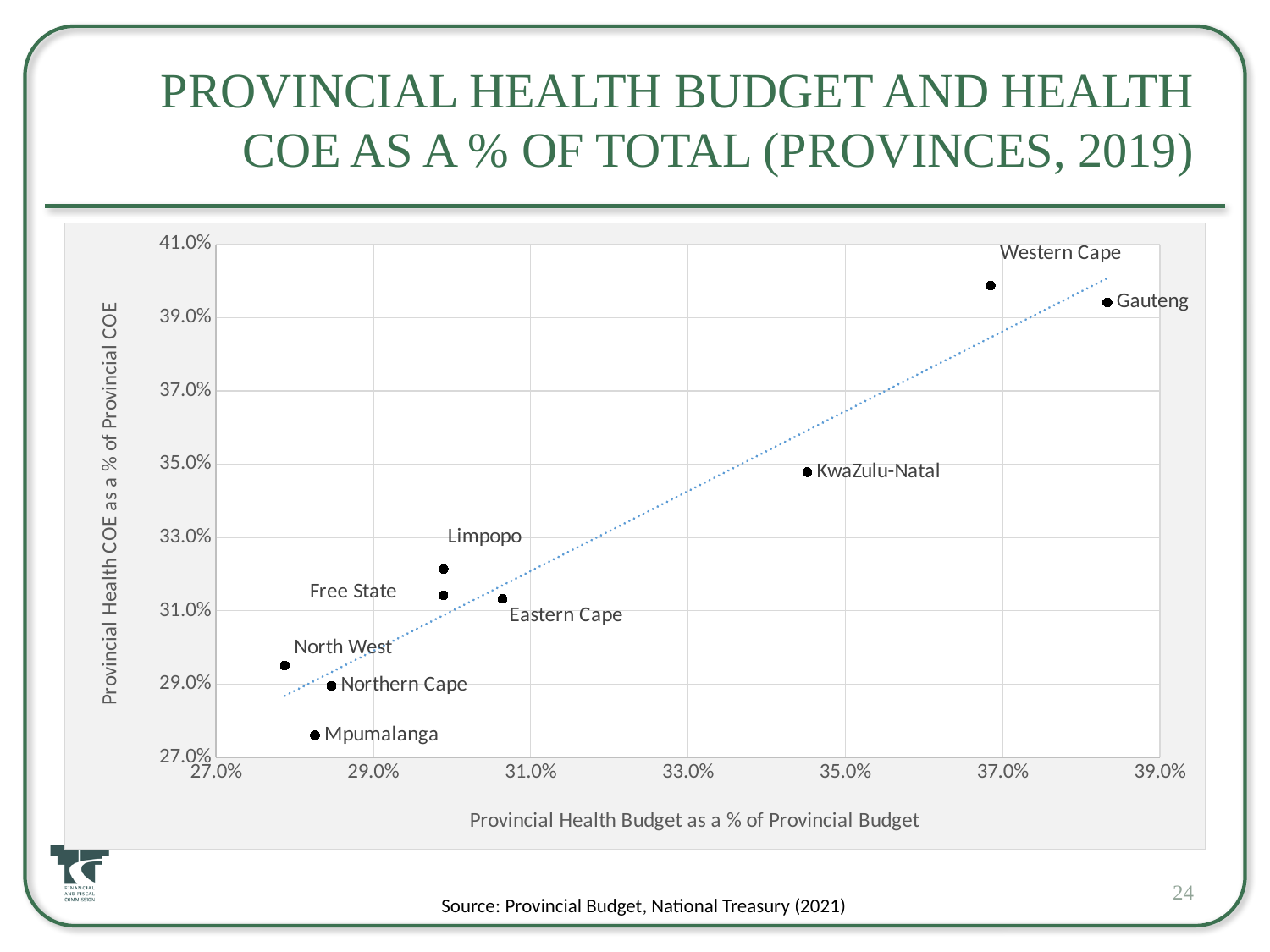
Which has a higher Provincial Health COE as a % of Provincial COE, Limpopo or Free State? Limpopo Which province has the lowest Provincial Health Budget as a % of Provincial Budget? North West What kind of chart is shown on the slide? Scatter chart Which province has the lowest Provincial Health COE as a % of Provincial COE? Mpumalanga Is the Provincial Health Budget as a % of Provincial Budget for Gauteng greater or less than 37.0%? greater Which province has the highest Provincial Health Budget as a % of Provincial Budget? Gauteng As Provincial Health Budget as a % of Provincial Budget increases, does Provincial Health COE as a % of Provincial COE generally rise or fall? Rise Which province has the highest Provincial Health COE as a % of Provincial COE? Western Cape How many provinces are plotted on the chart? 9 What is the title of the horizontal axis of the chart? Provincial Health Budget as a % of Provincial Budget Is the Provincial Health Budget as a % of Provincial Budget for KwaZulu-Natal greater or less than 33.0%? greater Is the Provincial Health COE as a % of Provincial COE for Mpumalanga greater or less than 29.0%? less